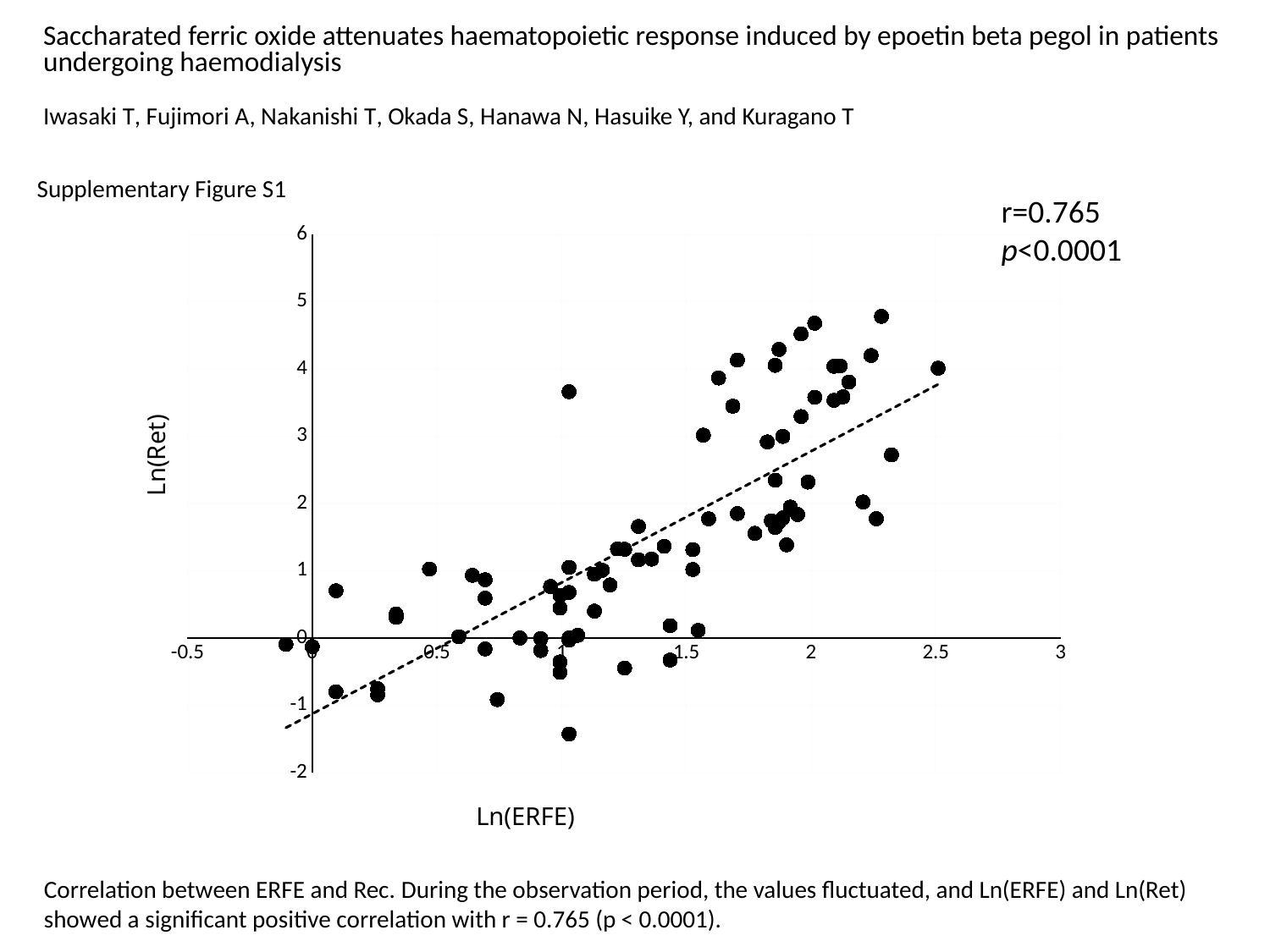
What is the correlation coefficient r shown on the chart? r=0.765 What is the label of the y axis? Ln(Ret) As Ln(ERFE) increases along the x axis, do the Ln(Ret) values generally rise or fall? rise What is the highest tick value shown on the y axis? 6 Does the dashed trend line slope upward or downward from left to right? upward Is the highest plotted Ln(Ret) value greater or less than 4? greater What kind of chart is shown on the slide? scatter plot Is the lowest plotted Ln(Ret) value greater or less than -1? less Is the largest plotted Ln(ERFE) value greater or less than 2? greater